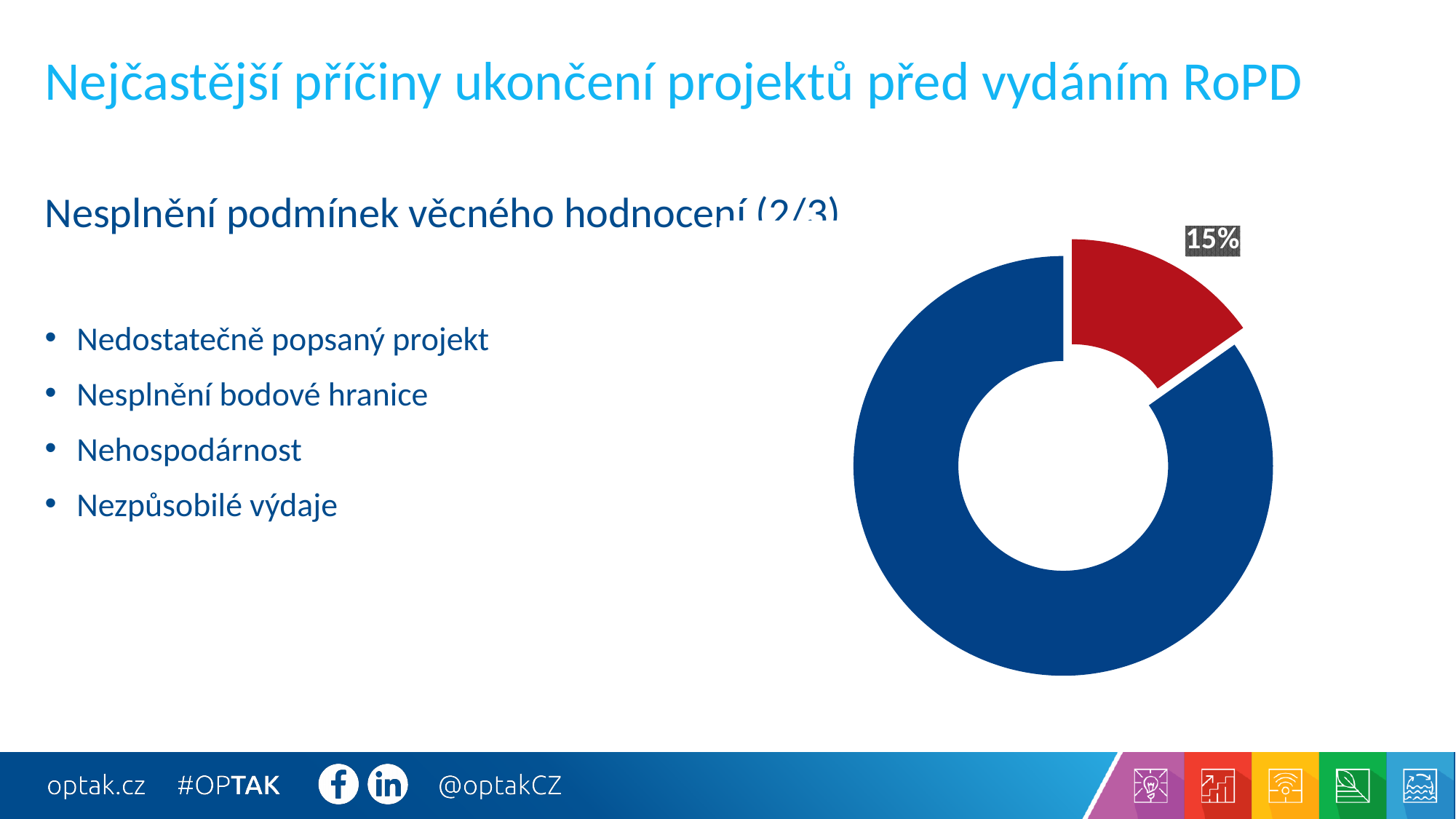
What value is printed on the red slice of the doughnut chart? 15% What share of the doughnut chart does the red slice represent? 15% What kind of chart is shown on the slide? doughnut chart How many slices of the doughnut chart have a data label printed? 1 Which slice of the doughnut chart is larger, the blue one or the red one? blue Is the red slice of the doughnut chart greater or less than 50% of the whole? less Which colour slice is the smallest in the doughnut chart? red Is the blue slice of the doughnut chart greater or less than 50% of the whole? greater How many slices does the doughnut chart have? 2 What colour is the slice that carries the 15% data label? red Which colour slice is the largest in the doughnut chart? blue